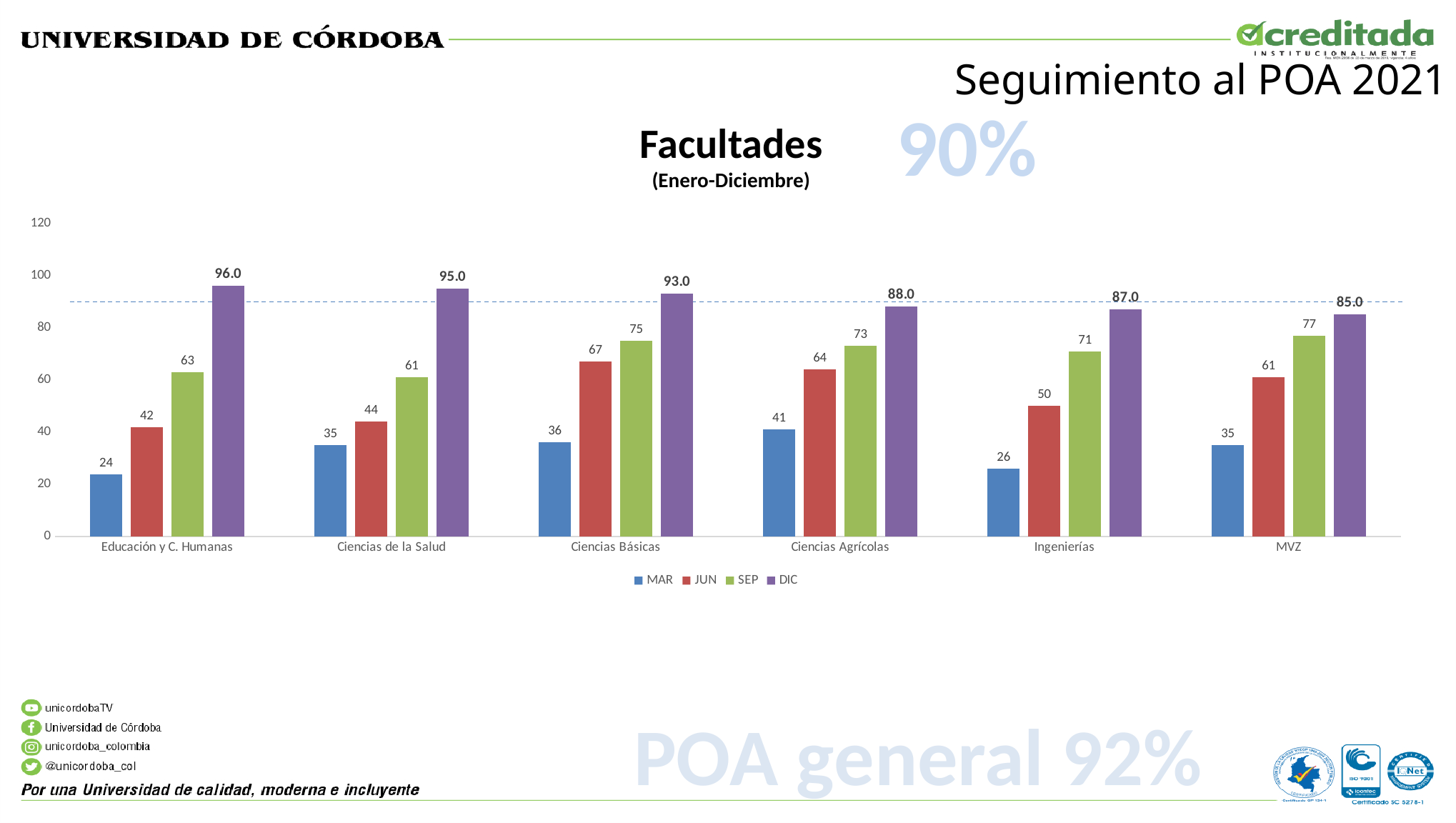
Which faculty has the lowest MAR value? Educación y C. Humanas What is the JUN value for Ciencias Básicas? 67 How many series does the legend list? 4 Which is larger, the SEP value for Ciencias de la Salud or the SEP value for Ciencias Agrícolas? Ciencias Agrícolas What kind of chart is shown on the slide? Bar chart What is the MAR value for Ingenierías? 26 Which faculty has the highest DIC value? Educación y C. Humanas What is the difference between the DIC and MAR values for Ciencias Agrícolas? 47 What is the DIC value for Educación y C. Humanas? 96.0 What is the title of the chart? Facultades (Enero-Diciembre) How many faculties are shown on the x axis? 6 What is the SEP value for MVZ? 77